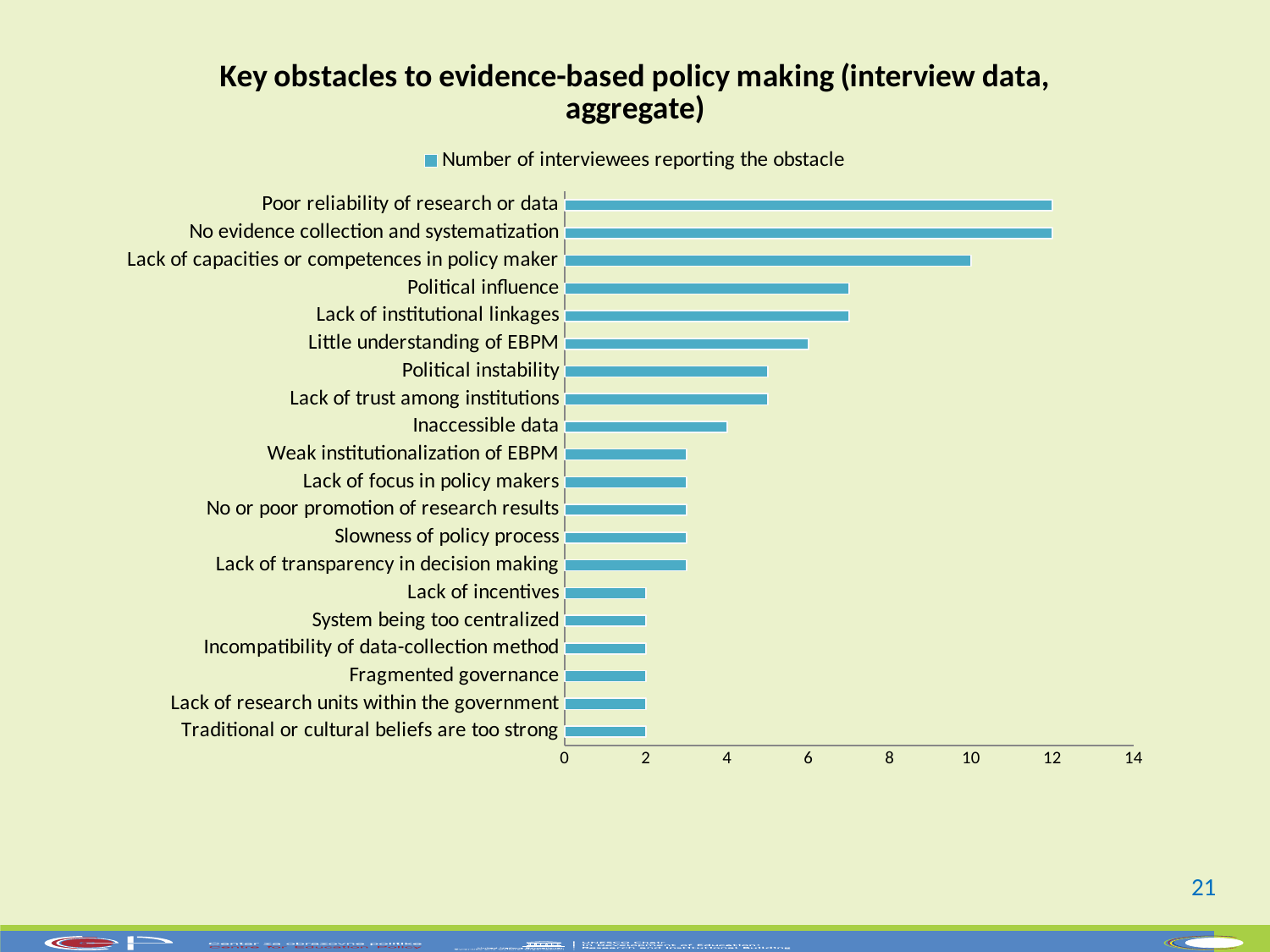
What is the title of the chart? Key obstacles to evidence-based policy making (interview data, aggregate) What is the number of interviewees reporting 'Lack of capacities or competences in policy maker'? 10 Which has a larger value: 'Lack of capacities or competences in policy maker' or 'Political influence'? Lack of capacities or competences in policy maker Is the value for 'Political influence' greater or less than 6? greater How many series does the legend list? 1 What is the number of interviewees reporting 'Little understanding of EBPM'? 6 What is the number of interviewees reporting 'Fragmented governance'? 2 How many obstacle categories are plotted in the chart? 20 Is the value for 'Slowness of policy process' greater or less than 4? less What is the difference between the values for 'Poor reliability of research or data' and 'Lack of capacities or competences in policy maker'? 2 What is the number of interviewees reporting 'Inaccessible data'? 4 What type of chart is shown on the slide? bar chart